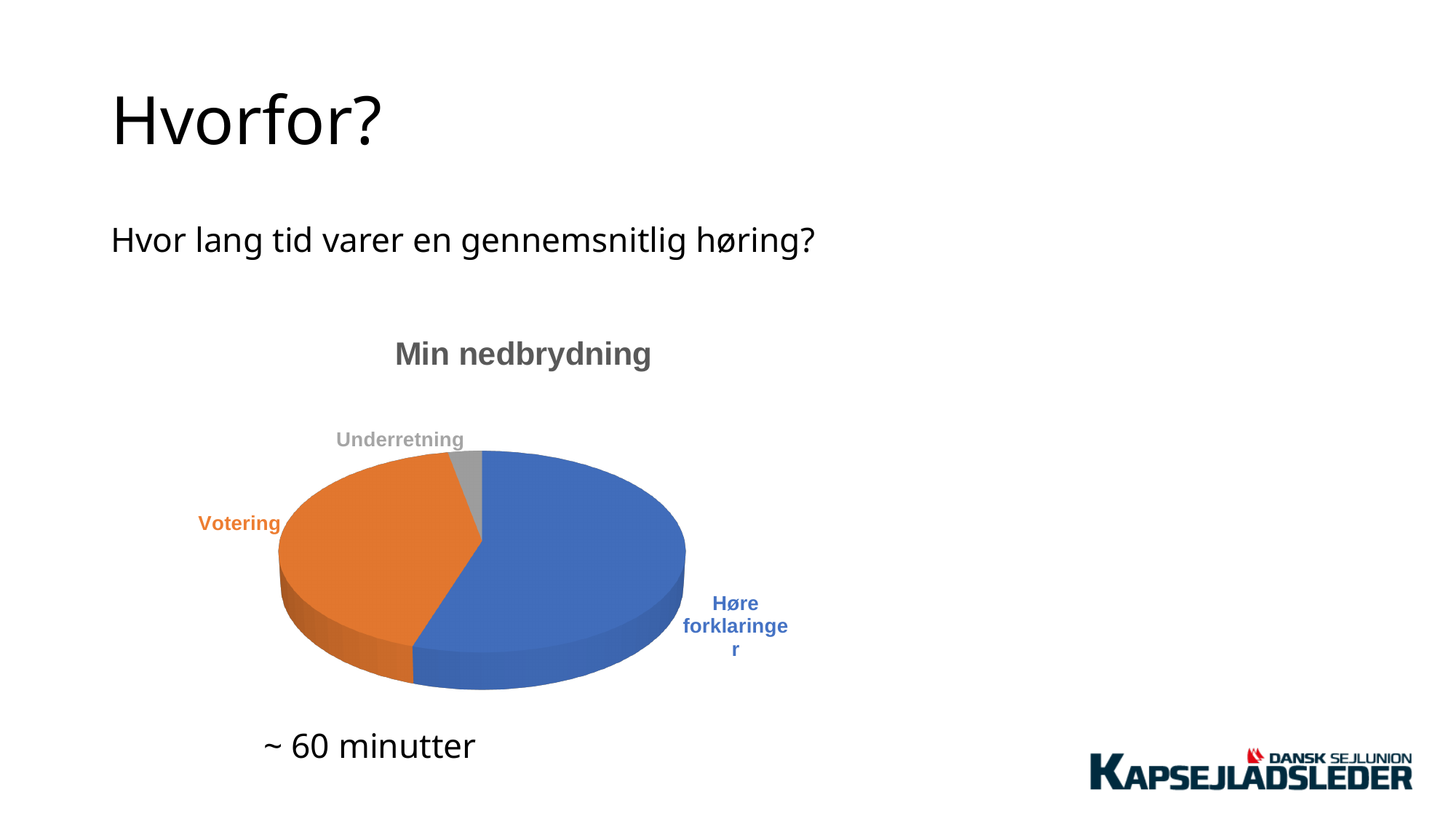
How many slices does the pie chart have? 3 What kind of chart is shown on the slide? pie chart What is the title of the chart? Min nedbrydning Which slice of the pie chart is the largest? Høre forklaringer What colour is the Votering slice? orange Which slice is larger, Votering or Underretning? Votering Which slice of the pie chart is the smallest? Underretning Which slice is larger, Høre forklaringer or Votering? Høre forklaringer